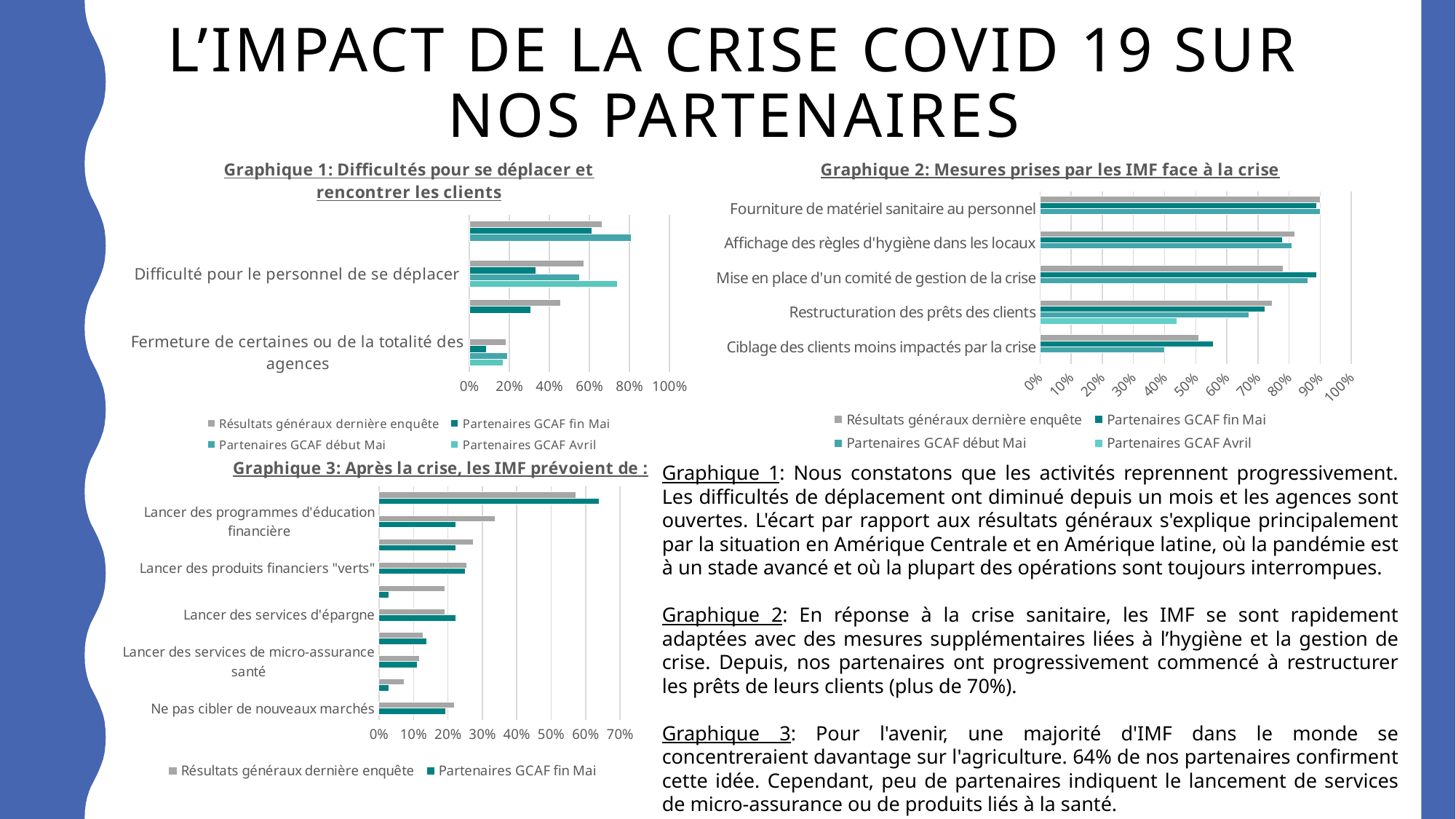
In Graphique 1, is the value of Partenaires GCAF Avril for Difficulté pour le personnel de se déplacer greater or less than 60%? greater In Graphique 3, is the value of Résultats généraux dernière enquête for Lancer des services de micro-assurance santé greater or less than 20%? less In Graphique 1, for Difficulté pour le personnel de se déplacer, which is larger: Partenaires GCAF Avril or Partenaires GCAF fin Mai? Partenaires GCAF Avril How many series does the legend of Graphique 1: Difficultés pour se déplacer et rencontrer les clients list? 4 In Graphique 2, is the value of Partenaires GCAF Avril for Restructuration des prêts des clients greater or less than 50%? less What kind of chart is Graphique 2: Mesures prises par les IMF face à la crise? bar chart In Graphique 2, which category has the lowest value for Résultats généraux dernière enquête? Ciblage des clients moins impactés par la crise In Graphique 2, which category has the highest value for Résultats généraux dernière enquête? Fourniture de matériel sanitaire au personnel How many series does the legend of Graphique 3: Après la crise, les IMF prévoient de : list? 2 How many categories are shown in Graphique 2: Mesures prises par les IMF face à la crise? 5